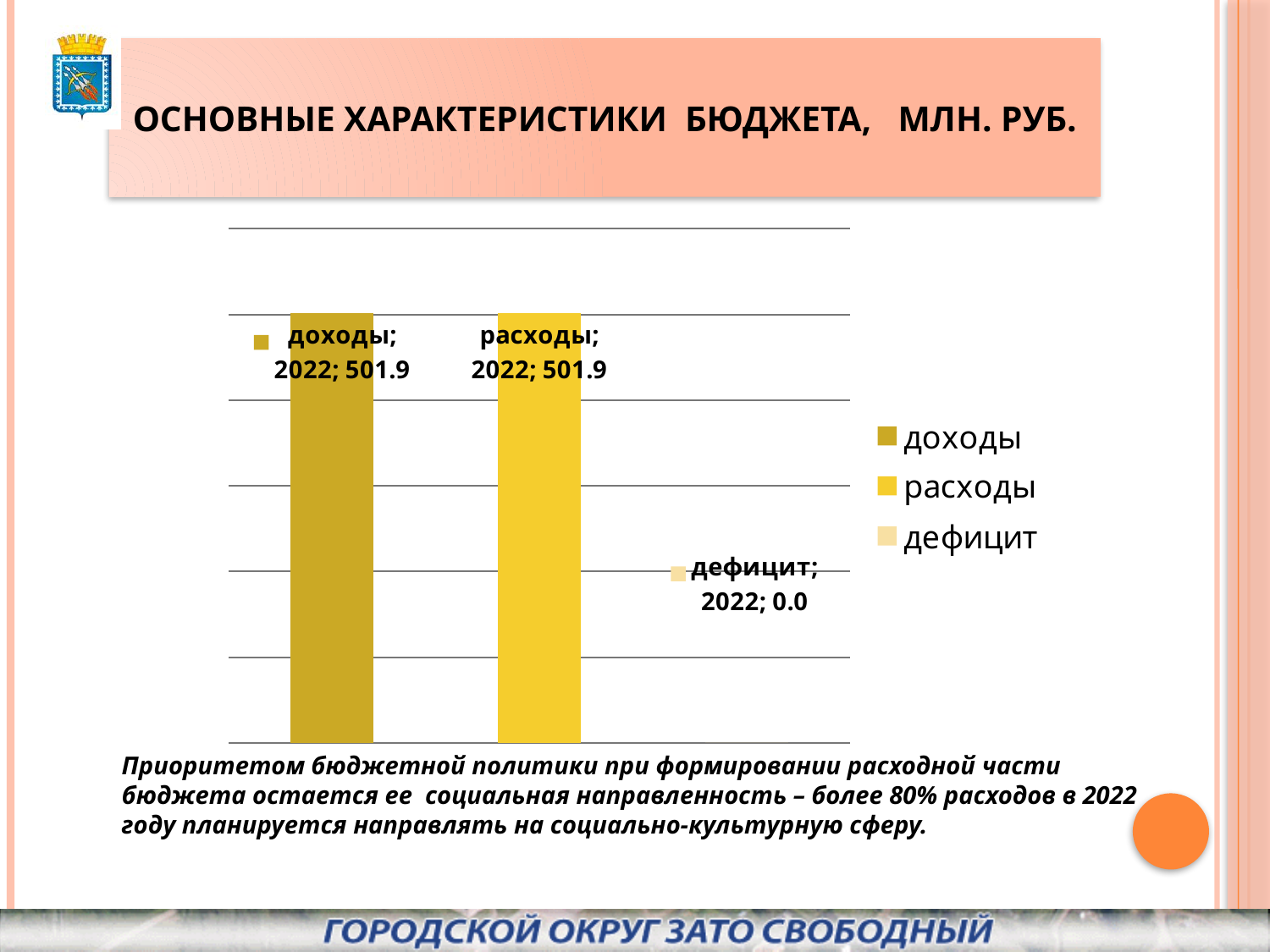
How many series does the legend list? 3 What is the value for дефицит in 2022? 0.0 What year do the data labels on the chart refer to? 2022 What is the value for доходы in 2022? 501.9 What is the difference between доходы and расходы in 2022? 0.0 Which series has the lowest value on the chart? дефицит Which is larger, the value for расходы or the value for дефицит? расходы How many bars with a non-zero value are shown on the chart? 2 What is the difference between доходы and дефицит in 2022? 501.9 What is the value for расходы in 2022? 501.9 What unit is stated in the chart title? МЛН. РУБ. What kind of chart is shown on the slide? bar chart